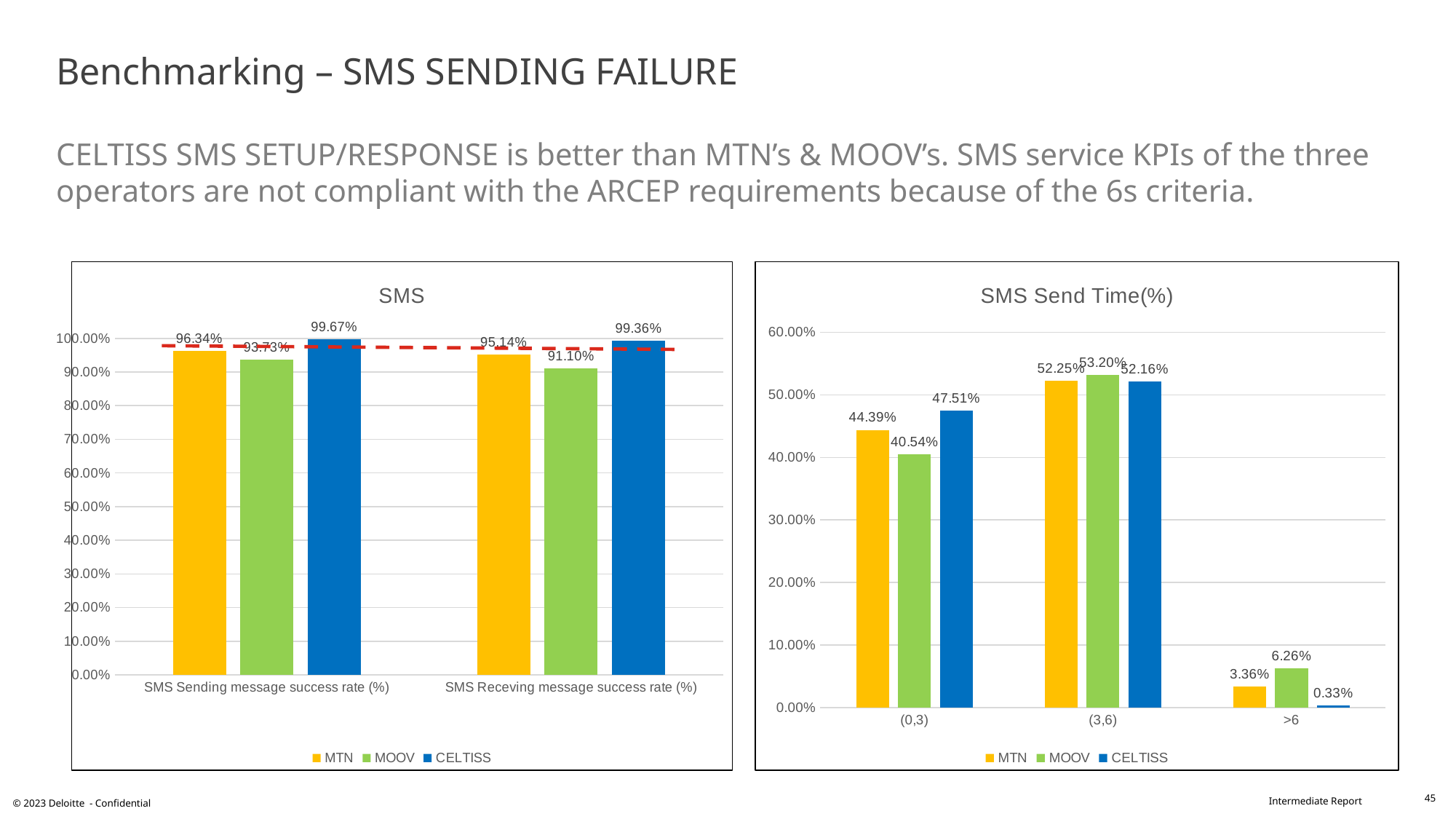
In the SMS chart, what is the SMS Receving message success rate (%) for MOOV? 91.10% In the SMS chart, which operator has the lowest SMS Receving message success rate (%)? MOOV In the SMS Send Time(%) chart, how many categories are shown on the x axis? 3 In the SMS Send Time(%) chart, what is the value for CELTISS in the >6 category? 0.33% In the SMS chart, what is the SMS Sending message success rate (%) for CELTISS? 99.67% What kind of chart is the SMS Send Time(%) chart? Bar chart In the SMS Send Time(%) chart, which is larger in the >6 category: MTN or MOOV? MOOV In the SMS chart, how many series does the legend list? 3 In the SMS Send Time(%) chart, what is the difference between MOOV's and MTN's values in the (3,6) category? 0.95% In the SMS Send Time(%) chart, which operator has the highest value in the (0,3) category? CELTISS In the SMS chart, what is the difference between CELTISS's and MTN's SMS Sending message success rate (%)? 3.33% In the SMS Send Time(%) chart, what is the value for MOOV in the (0,3) category? 40.54%